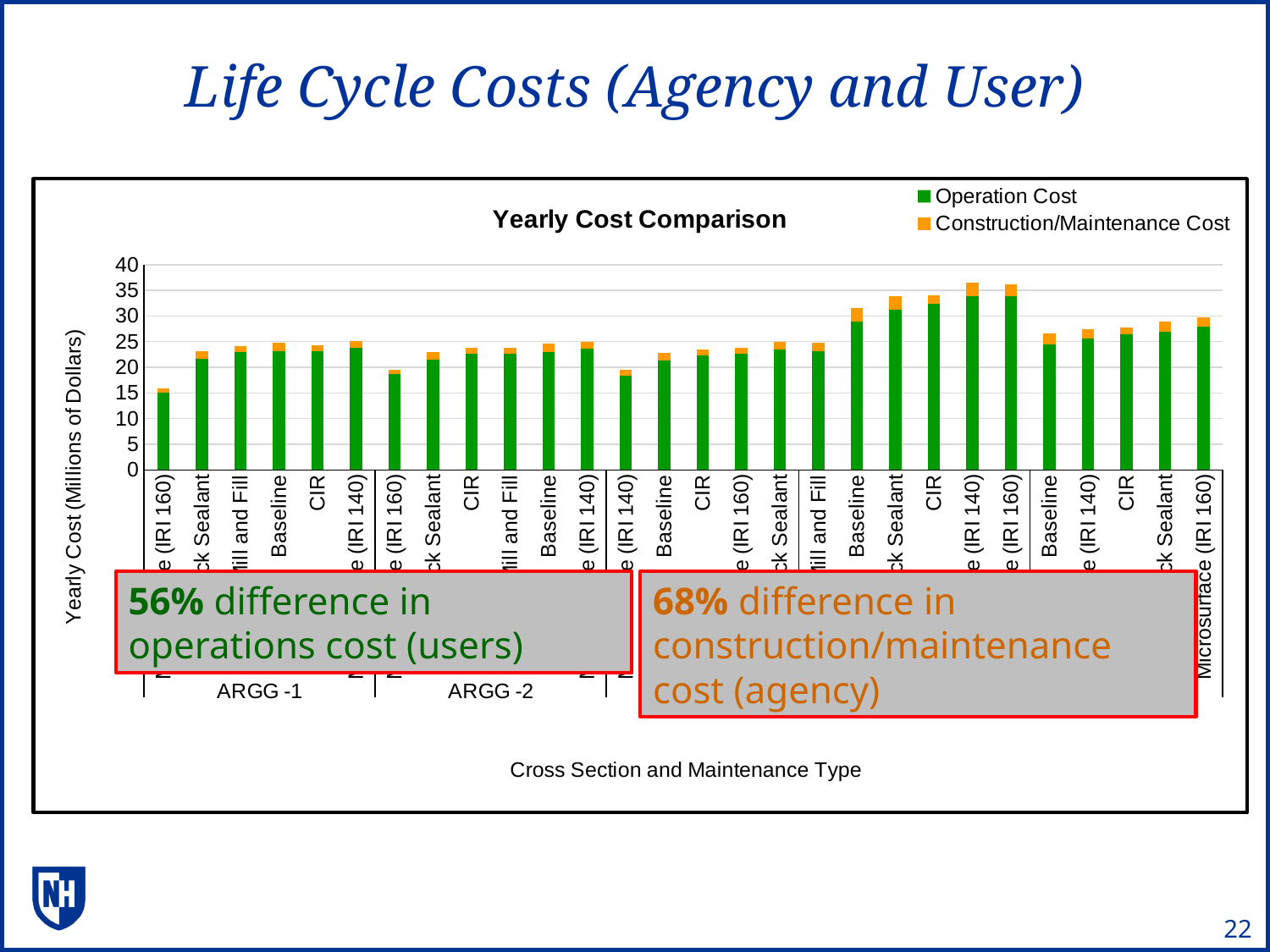
Is the total value for Baseline in the ARGG -2 group greater or less than 20? greater Which bar in the ARGG -1 group has the lowest total? the first bar (IRI 160) What is the title of the vertical axis of the Yearly Cost Comparison chart? Yearly Cost (Millions of Dollars) What are the two series named in the legend of the Yearly Cost Comparison chart? Operation Cost and Construction/Maintenance Cost Is the total value for CIR in the ARGG -2 group greater or less than 20? greater How many series does the legend of the Yearly Cost Comparison chart list? 2 Is the total value for Baseline in the ARGG -1 group greater or less than 20? greater Which is larger in the ARGG -1 group: the total for Baseline or the total for the first bar? Baseline What kind of chart is shown on the slide? bar chart Which is larger: the total for CIR in the ARGG -1 group or the total for the first bar in the ARGG -2 group? CIR in ARGG -1